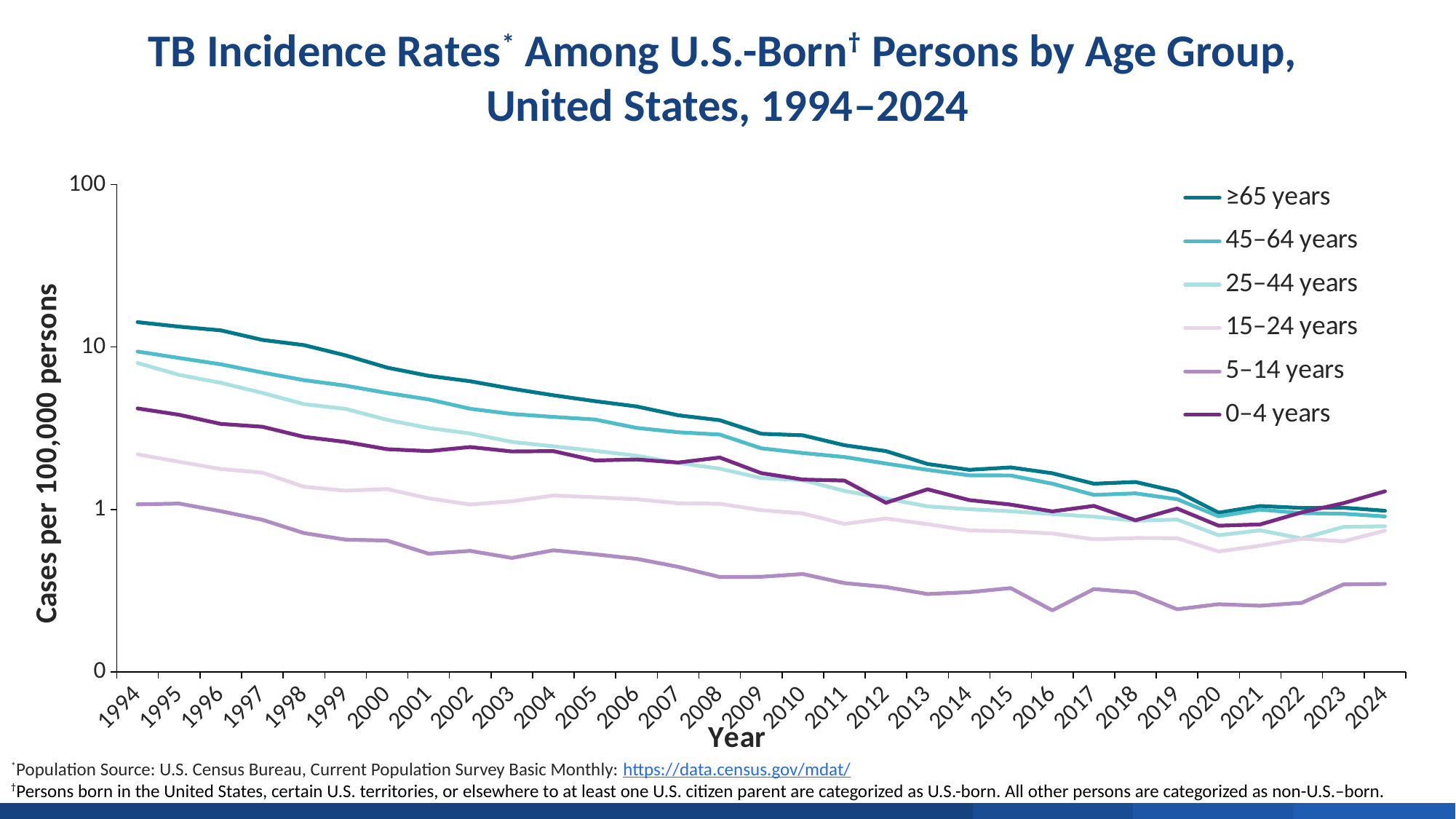
How many series does the legend list? 6 Which age group has the lowest TB incidence rate in 1994? 5–14 years Which age group has the highest TB incidence rate in 2024? 0–4 years Is the value for ≥65 years in 1994 greater or less than 10? greater Does the TB incidence rate for ≥65 years generally rise or fall from 1994 to 2024? Fall What kind of chart is shown on the slide? Line chart What is the label of the y axis? Cases per 100,000 persons Is the value for 5–14 years in 2016 greater or less than 1? less Is the value for 0–4 years in 1994 greater or less than 1? greater Which age group has the highest TB incidence rate in 1994? ≥65 years How many years are plotted along the x axis? 31 Which age group has the lowest TB incidence rate in 2024? 5–14 years